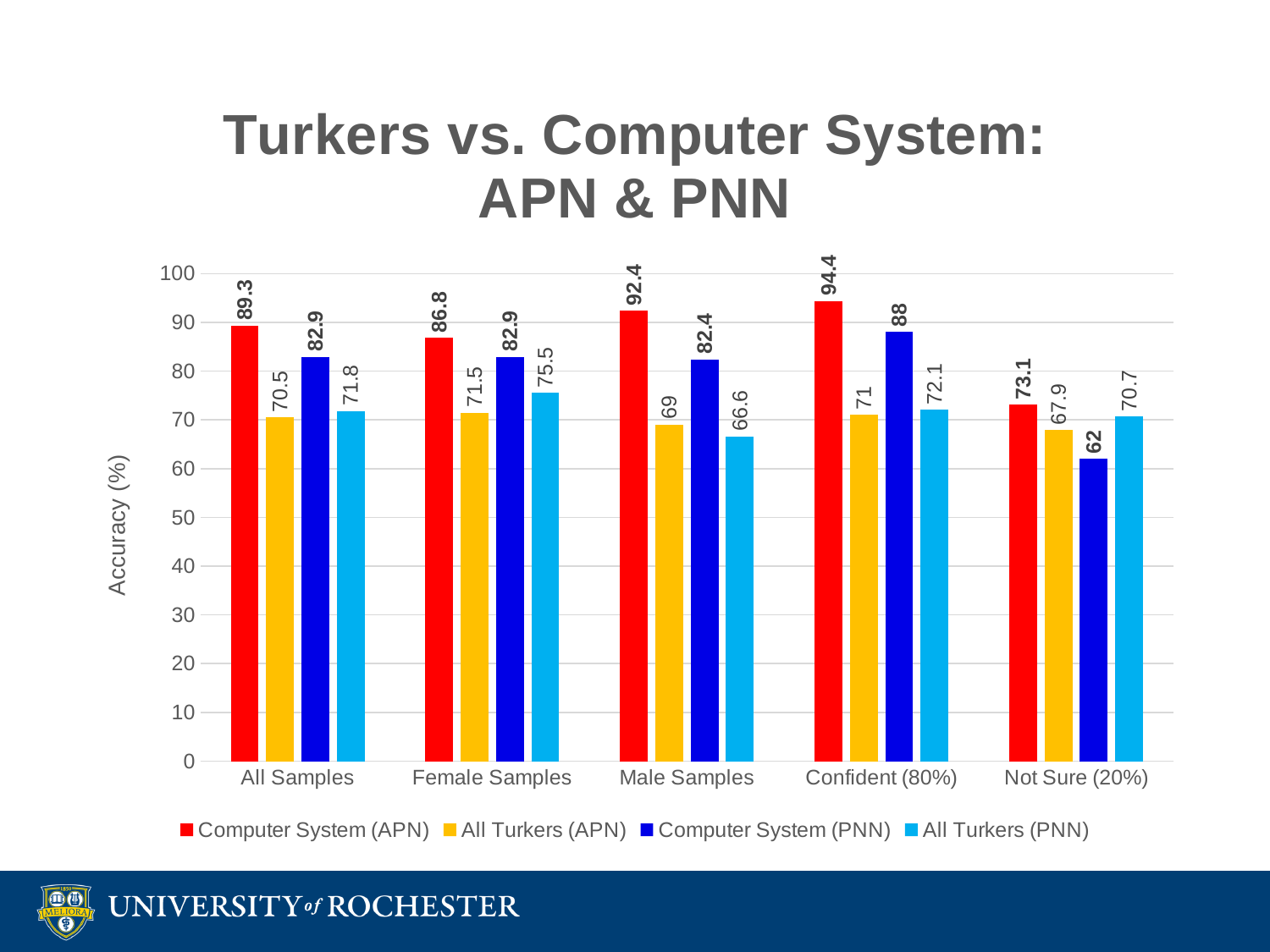
Which series is shown in red? Computer System (APN) What is the label of the y axis? Accuracy (%) For Not Sure (20%), which is larger: All Turkers (APN) or All Turkers (PNN)? All Turkers (PNN) What is the accuracy of the Computer System (APN) for All Samples? 89.3 Which category has the highest Computer System (APN) accuracy? Confident (80%) How many series does the legend list? 4 What is the difference between the Computer System (APN) and All Turkers (APN) accuracy for Male Samples? 23.4 What is the accuracy of All Turkers (PNN) for Female Samples? 75.5 How many categories are shown on the x axis? 5 What kind of chart is shown on the slide? Bar chart Which category has the lowest Computer System (PNN) accuracy? Not Sure (20%) What is the accuracy of the Computer System (PNN) for Not Sure (20%)? 62